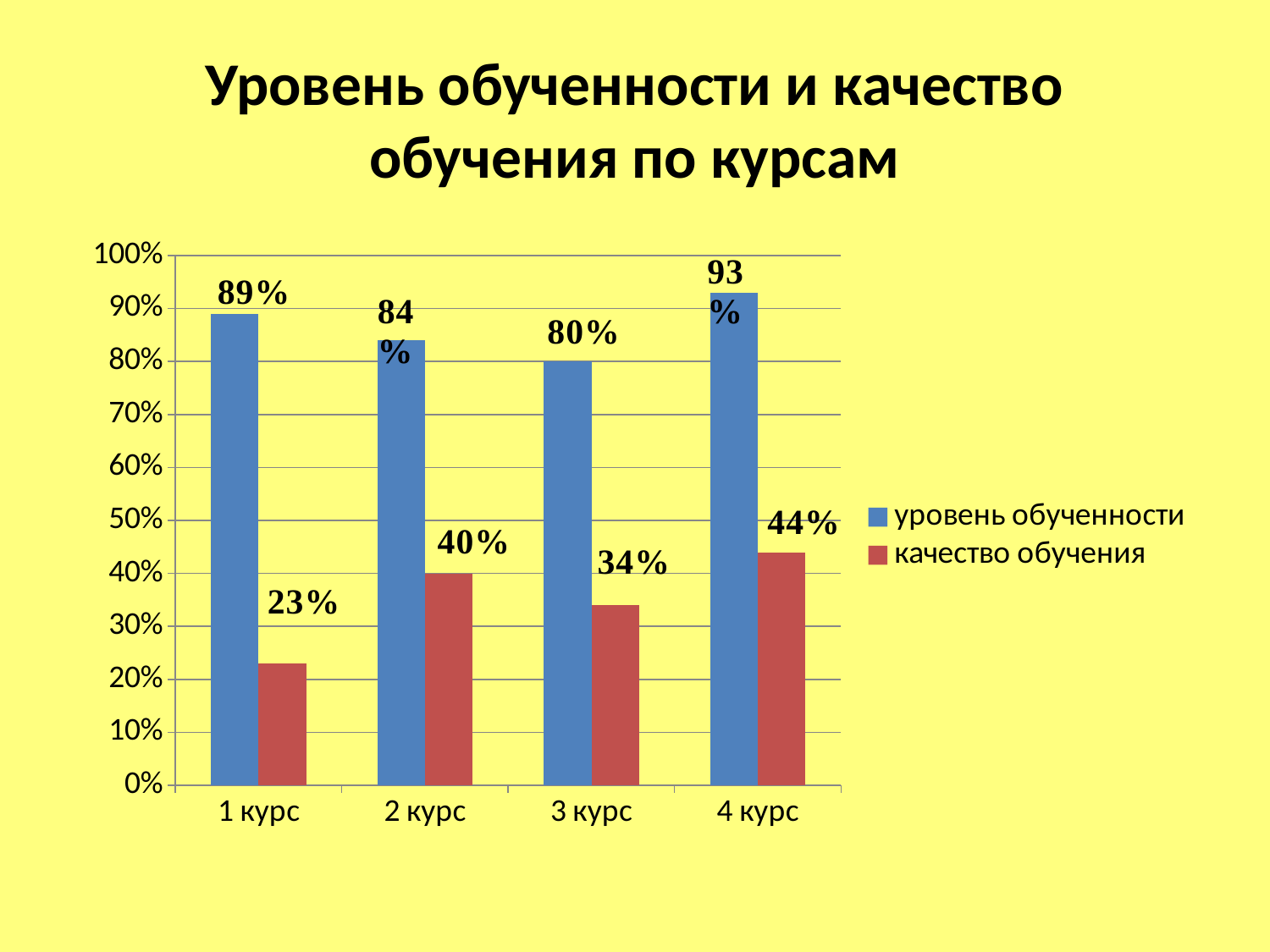
How many series does the legend list? 2 What is the value of уровень обученности for 4 курс? 93% What is the value of уровень обученности for 1 курс? 89% What is the difference between уровень обученности and качество обучения for 1 курс? 66% What kind of chart is shown on the slide? Bar chart What is the value of качество обучения for 2 курс? 40% Which course has the highest уровень обученности? 4 курс What is the value of качество обучения for 3 курс? 34% How many courses are shown on the x axis? 4 What colour are the bars for качество обучения? Red Which is larger: качество обучения for 2 курс or for 4 курс? 4 курс Which course has the lowest качество обучения? 1 курс